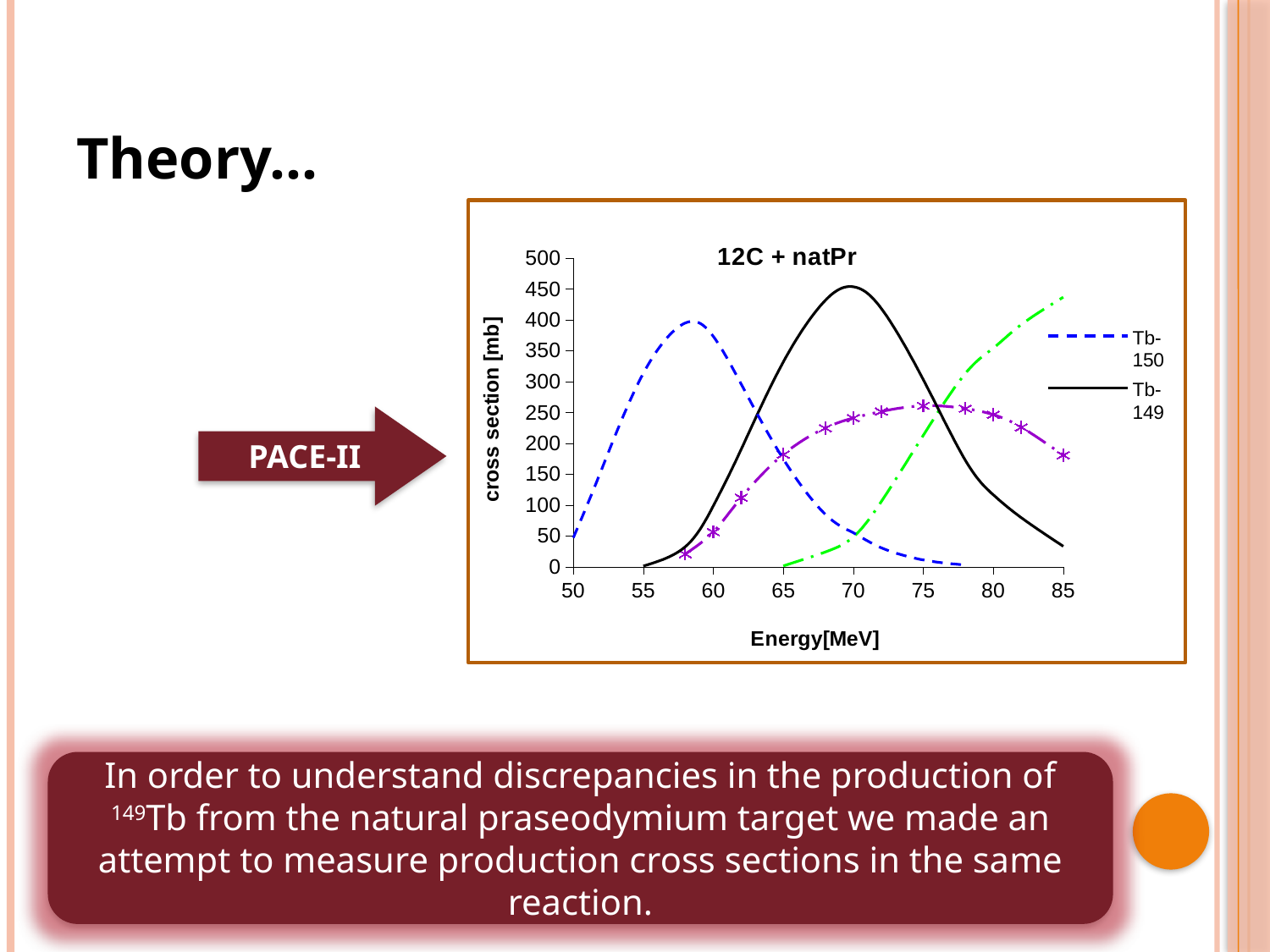
Is the peak value of the Tb-149 curve greater or less than 400? greater Which of the two legend series reaches the higher peak cross section? Tb-149 Is the value of the Tb-149 curve at 85 MeV greater or less than 50? less What kind of chart is shown on the slide? line chart What is the title of the chart? 12C + natPr Does the Tb-150 curve rise or fall as energy increases from 60 MeV to 80 MeV? fall How many series does the chart's legend list? 2 Is the value of the Tb-150 curve at 65 MeV greater or less than 150? greater What is the label of the x axis of the chart? Energy[MeV] At 55 MeV, which series has the larger cross section, Tb-150 or Tb-149? Tb-150 At 70 MeV, which series has the larger cross section, Tb-150 or Tb-149? Tb-149